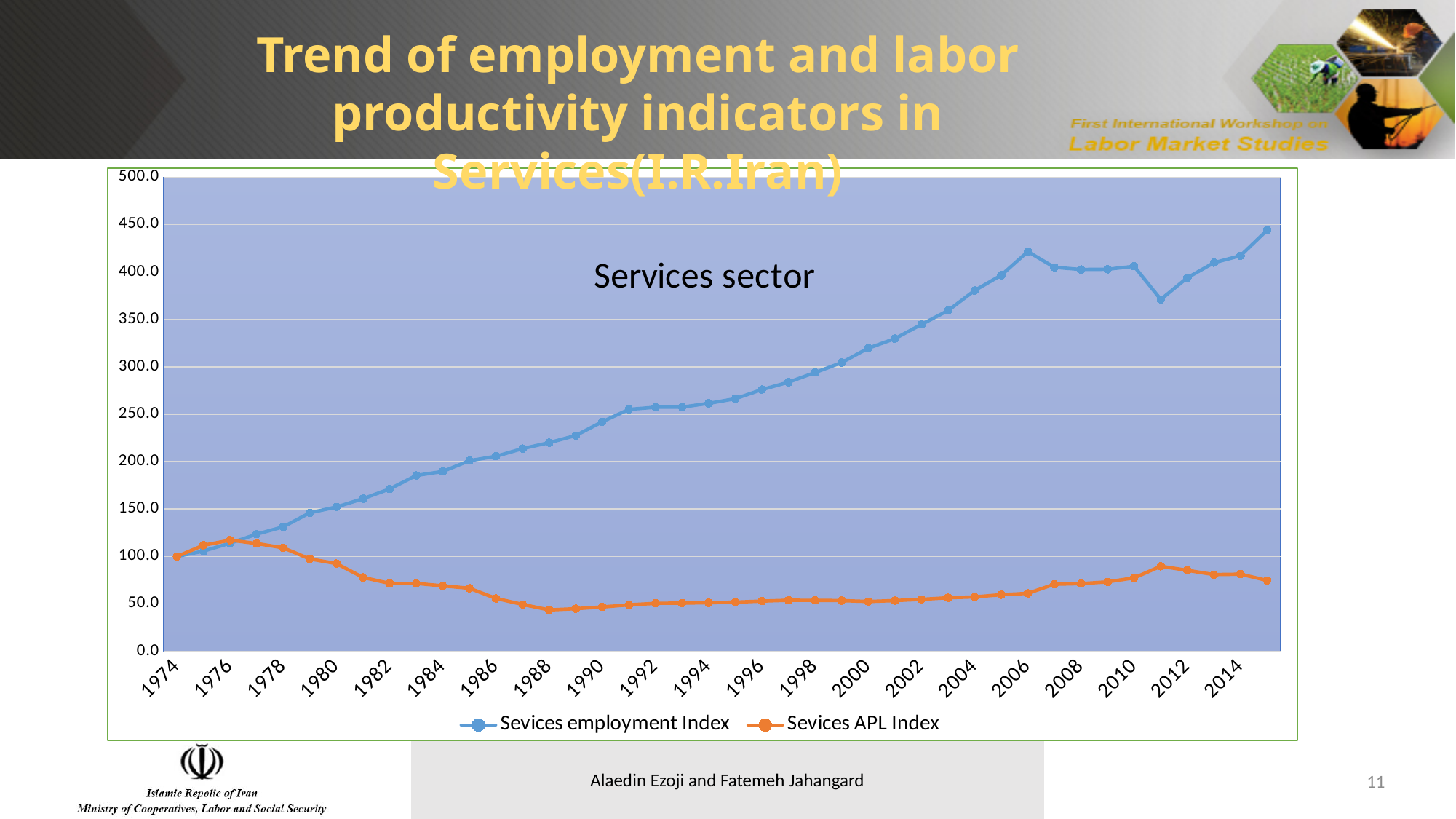
Is the Sevices APL Index in 1988 greater or less than 50? less Does the Sevices employment Index generally rise or fall from 1974 to 2014? rise Is the Sevices employment Index in 1984 greater or less than 200? less What kind of chart is shown on the slide? line chart Is the Sevices employment Index in 2000 greater or less than 300? greater What title is printed inside the plot area of the chart? Services sector Does the Sevices APL Index rise or fall between 1978 and 1988? fall What are the two series named in the legend? Sevices employment Index and Sevices APL Index How many year labels are shown on the x axis? 21 In 2000, which series has the higher value, Sevices employment Index or Sevices APL Index? Sevices employment Index How many series does the legend list? 2